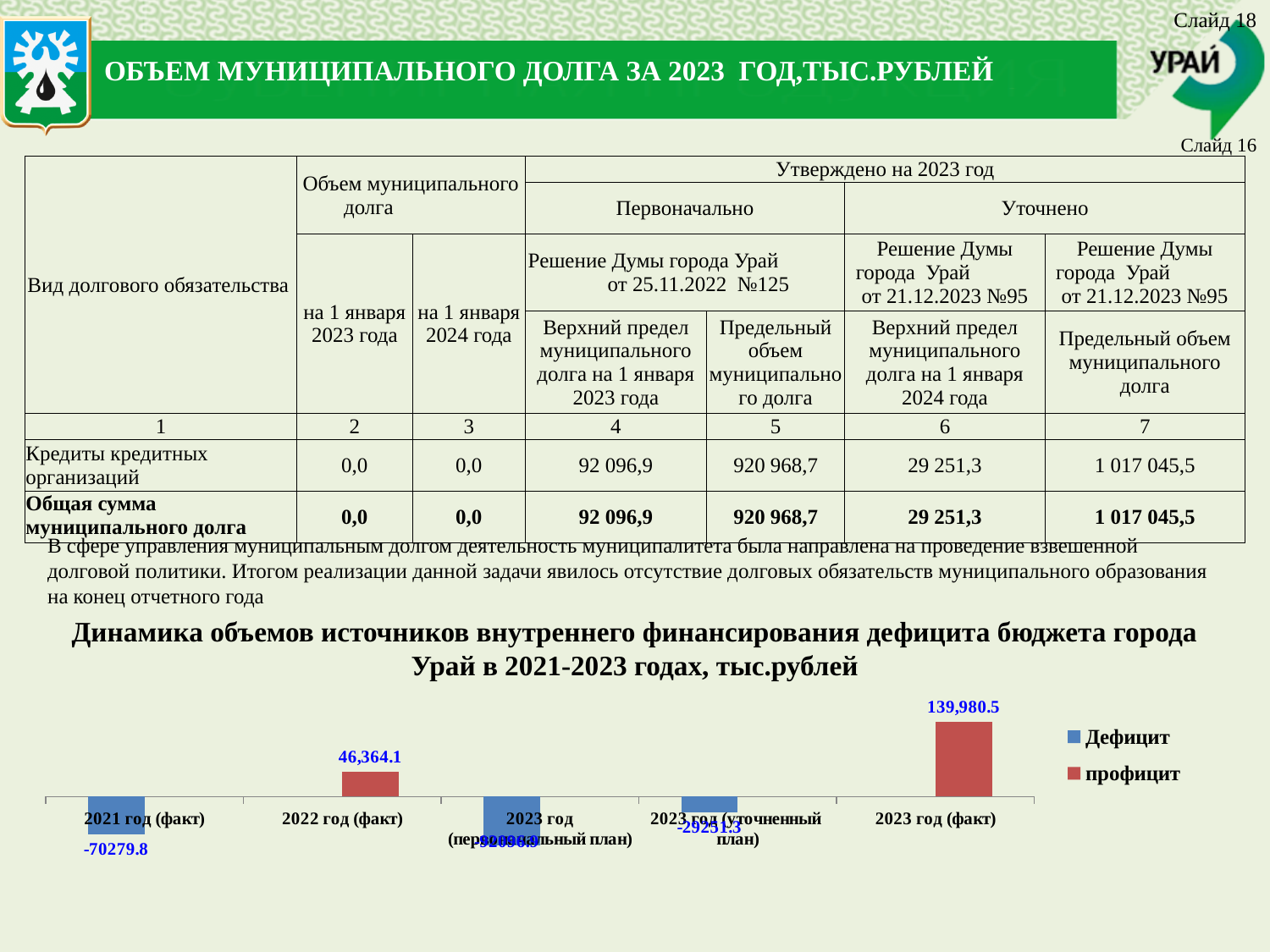
What kind of chart is shown at the bottom of the slide? Bar chart In the bar chart at the bottom of the slide, what is the difference between the value for 2023 год (факт) and the value for 2022 год (факт)? 93,616.4 How many series does the legend of the bar chart at the bottom of the slide list? 2 How many categories are shown on the x axis of the bar chart at the bottom of the slide? 5 In the bar chart at the bottom of the slide, which colour represents Дефицит? Blue What is the value for 2023 год (факт) in the bar chart at the bottom of the slide? 139,980.5 Which category has the highest value in the bar chart at the bottom of the slide? 2023 год (факт) In the bar chart at the bottom of the slide, which is larger: the value for 2022 год (факт) or the value for 2023 год (факт)? 2023 год (факт) What are the two legend entries of the bar chart at the bottom of the slide? Дефицит and профицит What is the value for 2023 год (уточненный план) in the bar chart at the bottom of the slide? -29251.3 What is the value for 2022 год (факт) in the bar chart at the bottom of the slide? 46,364.1 What is the value for 2021 год (факт) in the chart 'Динамика объемов источников внутреннего финансирования дефицита бюджета города Урай в 2021-2023 годах'? -70279.8